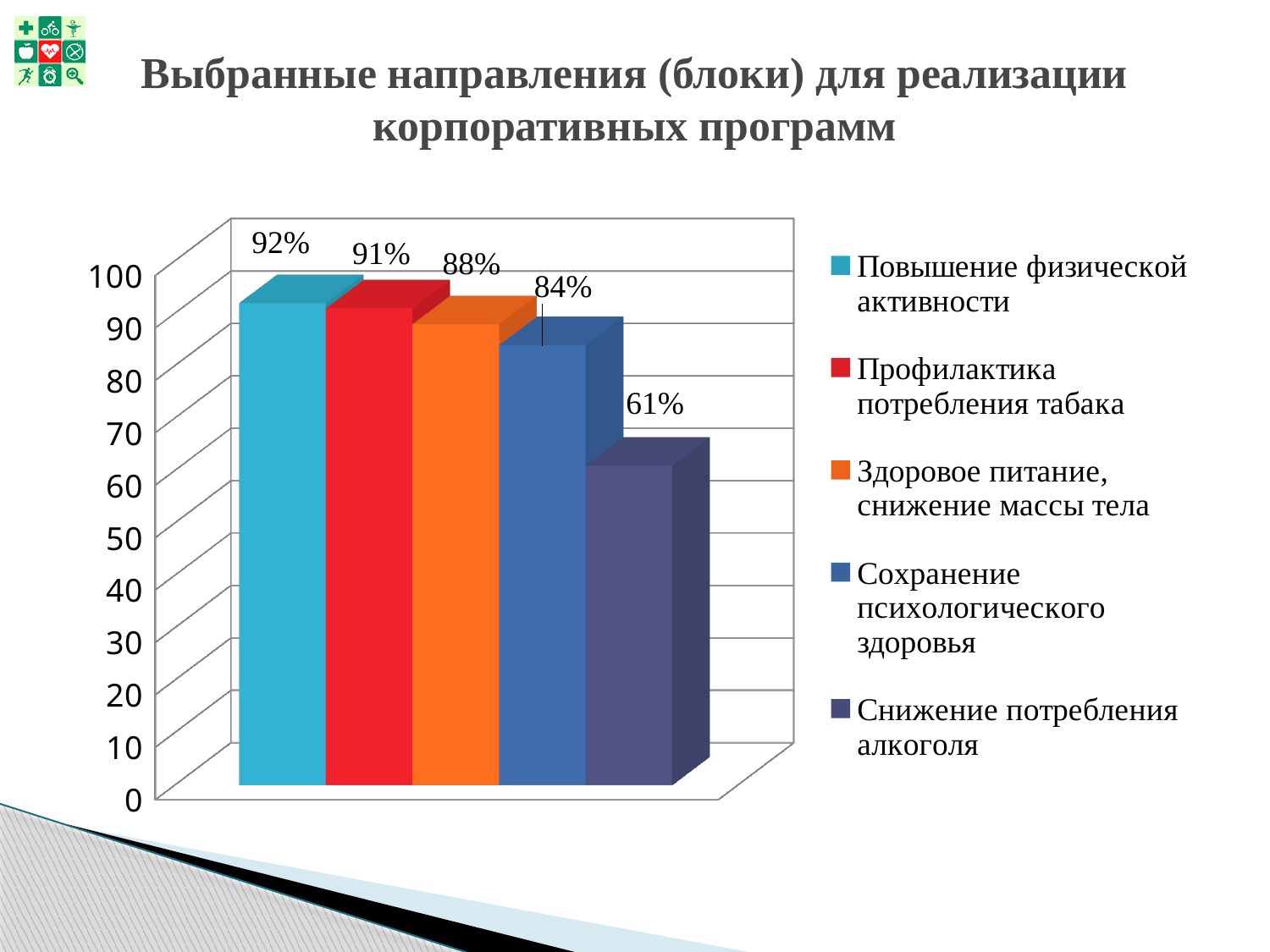
What kind of chart is shown on the slide? Bar chart What colour is the bar for Профилактика потребления табака? Red What is the value for Профилактика потребления табака? 91% What is the value for Снижение потребления алкоголя? 61% Which series has the lowest value? Снижение потребления алкоголя What is the value for Здоровое питание, снижение массы тела? 88% What is the value for Сохранение психологического здоровья? 84% How many series does the legend list? 5 Which series has the highest value? Повышение физической активности What is the value for Повышение физической активности? 92% Which is larger: the value for Здоровое питание, снижение массы тела or the value for Сохранение психологического здоровья? Здоровое питание, снижение массы тела What is the difference between the values for Повышение физической активности and Снижение потребления алкоголя? 31%